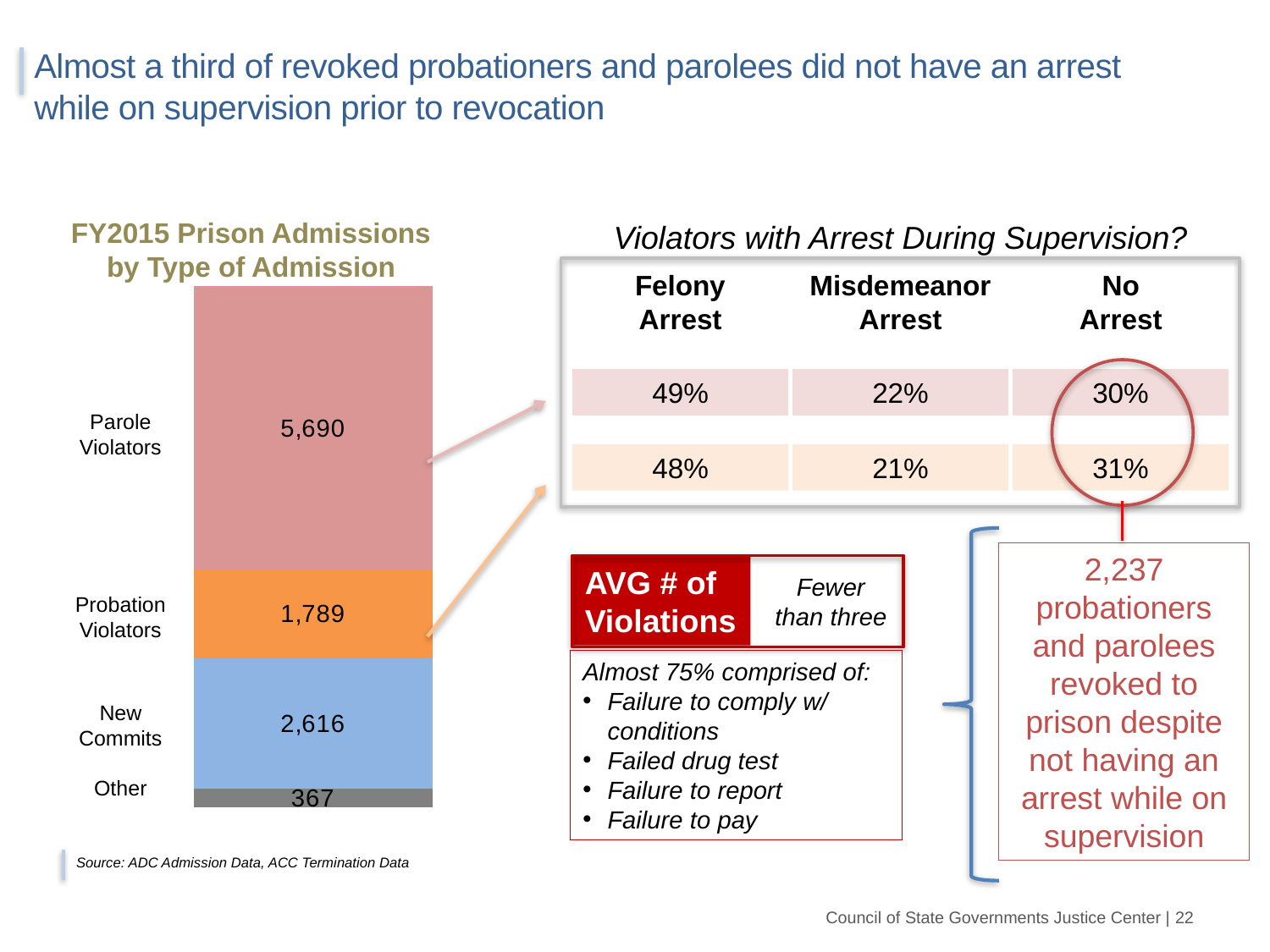
In the FY2015 Prison Admissions by Type of Admission chart, what is the value for New Commits? 2,616 In the FY2015 Prison Admissions by Type of Admission chart, what is the difference between Parole Violators and Probation Violators? 3,901 In the FY2015 Prison Admissions by Type of Admission chart, what is the difference between New Commits and Probation Violators? 827 In the FY2015 Prison Admissions by Type of Admission chart, which type of admission has the lowest value? Other How many types of admission are shown in the FY2015 Prison Admissions by Type of Admission chart? 4 In the FY2015 Prison Admissions by Type of Admission chart, which type of admission has the highest value? Parole Violators In the FY2015 Prison Admissions by Type of Admission chart, what is the value for Probation Violators? 1,789 In the FY2015 Prison Admissions by Type of Admission chart, what is the value for Parole Violators? 5,690 In the FY2015 Prison Admissions by Type of Admission chart, which is larger: New Commits or Probation Violators? New Commits What is the total of all segments in the FY2015 Prison Admissions by Type of Admission stacked bar? 10,462 In the FY2015 Prison Admissions by Type of Admission chart, what is the value for Other? 367 What kind of chart is the FY2015 Prison Admissions by Type of Admission chart? Stacked bar chart